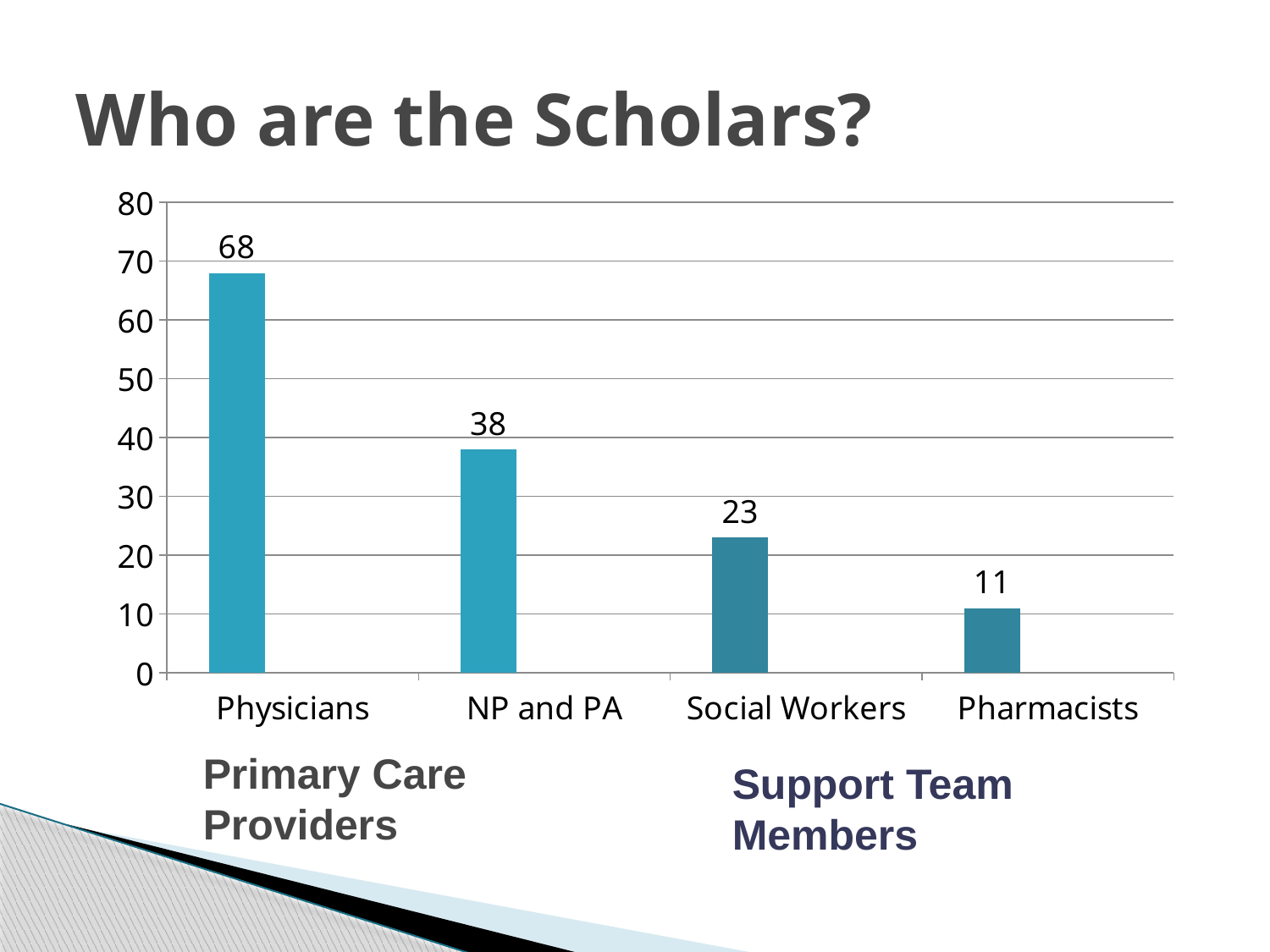
Which category has the lowest value? Pharmacists How many categories are shown on the x axis? 4 What is the difference between the values for Physicians and NP and PA? 30 What is the value for Pharmacists? 11 What is the value for Physicians? 68 Do the values rise or fall from left to right along the x axis? Fall What is the difference between the values for Social Workers and Pharmacists? 12 What is the value for NP and PA? 38 What kind of chart is shown on the slide? Bar chart Which category has the highest value? Physicians Which is larger, the value for NP and PA or the value for Social Workers? NP and PA What is the value for Social Workers? 23